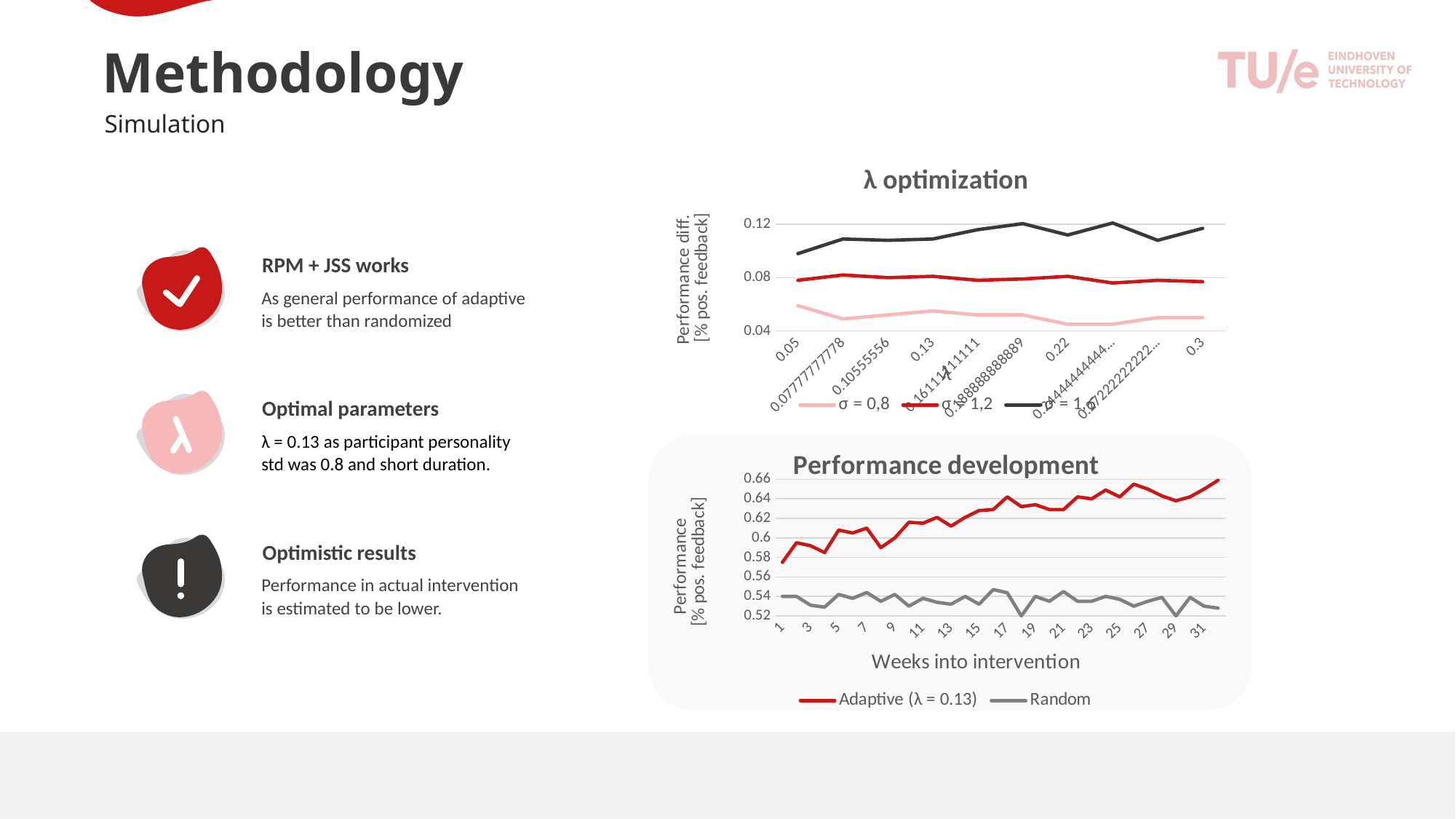
In the "Performance development" chart, which series is higher at week 31, Adaptive (λ = 0.13) or Random? Adaptive (λ = 0.13) How many series does the legend of the "Performance development" chart list? 2 What kind of chart is the "Performance development" chart? line chart In the "λ optimization" chart, which series has the highest values across the λ range? σ = 1,6 How many series does the legend of the "λ optimization" chart list? 3 In the "λ optimization" chart, which series has the lowest values across the λ range? σ = 0,8 In the "Performance development" chart, is the Random value at week 17 greater or less than 0.58? less What is the x-axis title of the "Performance development" chart? Weeks into intervention In the "λ optimization" chart, is the value for σ = 0,8 at λ = 0.05 greater or less than 0.08? less In the "Performance development" chart, does the Adaptive (λ = 0.13) series rise or fall over the weeks into intervention? rise In the "λ optimization" chart, is the value for σ = 1,6 at λ = 0.3 greater or less than 0.08? greater What kind of chart is the "λ optimization" chart? line chart